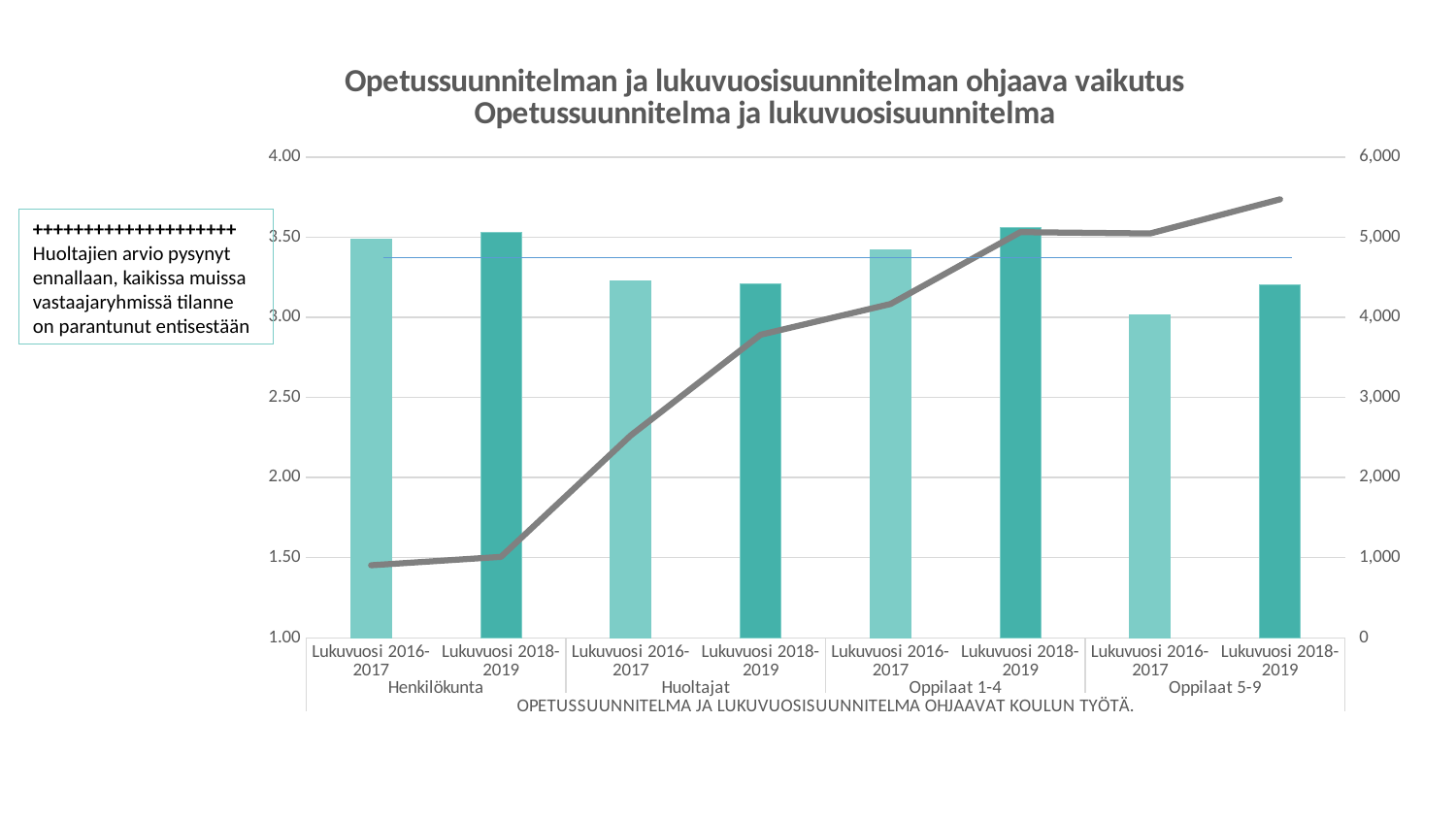
What kind of chart is shown on the slide? A combined bar and line chart How many bars are plotted in the chart? 8 How many respondent groups are shown along the x axis? 4 On the right-hand axis, is the line value at Huoltajat, Lukuvuosi 2016-2017 greater or less than 3,000? less For Oppilaat 5-9, which bar is taller: Lukuvuosi 2016-2017 or Lukuvuosi 2018-2019? Lukuvuosi 2018-2019 On the right-hand axis, is the line value at Oppilaat 5-9, Lukuvuosi 2018-2019 greater or less than 5,000? greater Which bar is the lowest in the chart? Oppilaat 5-9, Lukuvuosi 2016-2017 Does the grey line generally rise or fall from left to right across the chart? Rise Is the bar value for Oppilaat 5-9, Lukuvuosi 2016-2017 greater or less than 3.50? less For Oppilaat 1-4, which bar is taller: Lukuvuosi 2016-2017 or Lukuvuosi 2018-2019? Lukuvuosi 2018-2019 What is the first line of the chart title? Opetussuunnitelman ja lukuvuosisuunnitelman ohjaava vaikutus